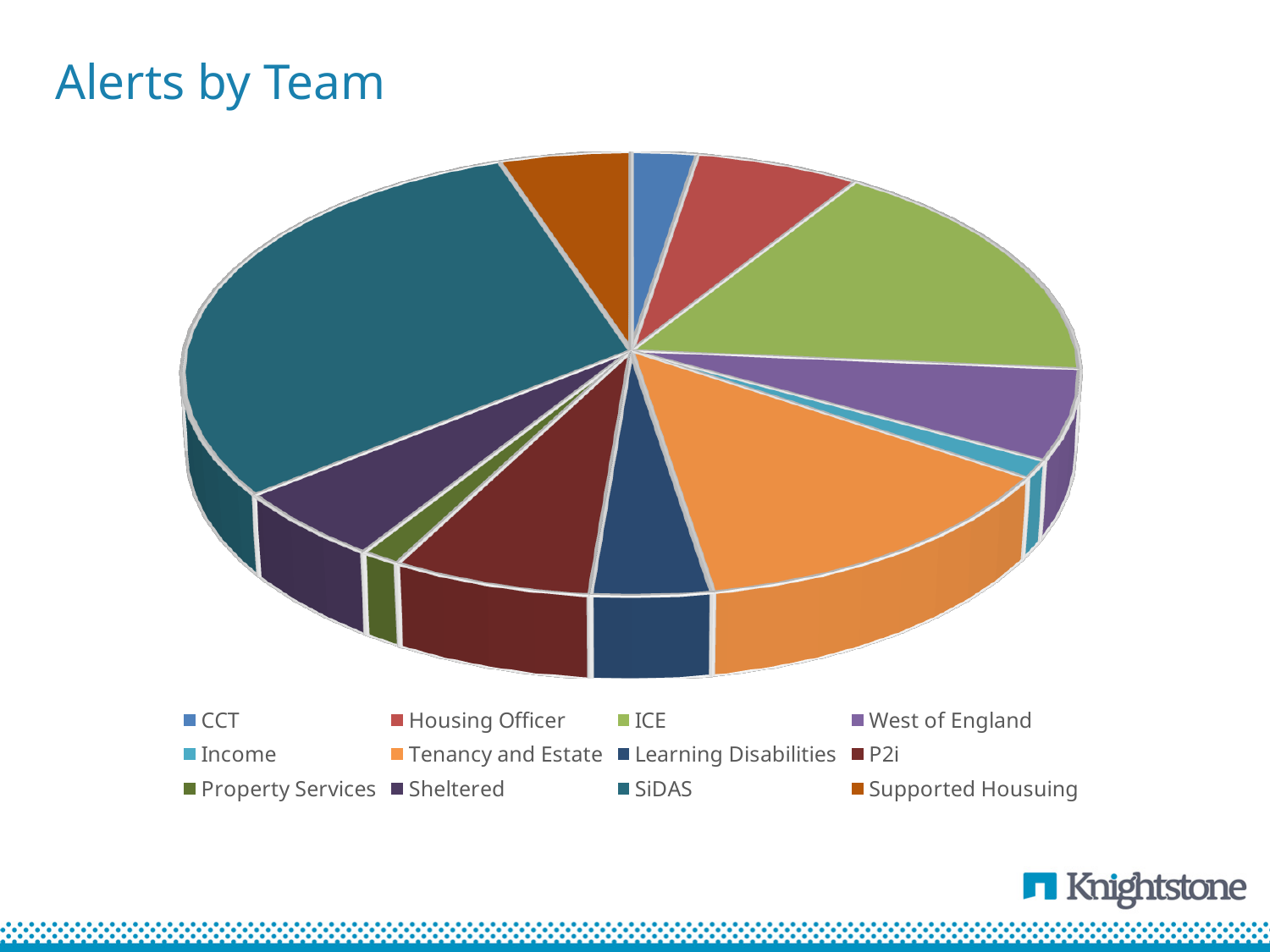
What colour is the SiDAS slice in the pie chart? Teal Which slice is larger, P2i or Property Services? P2i Which slice is larger, Housing Officer or Income? Housing Officer Which slice is larger, Tenancy and Estate or Learning Disabilities? Tenancy and Estate Which team has the largest slice of the pie? SiDAS How many teams (slices) does the pie chart show? 12 What kind of chart is shown on the slide? Pie chart What is the title of the chart? Alerts by Team